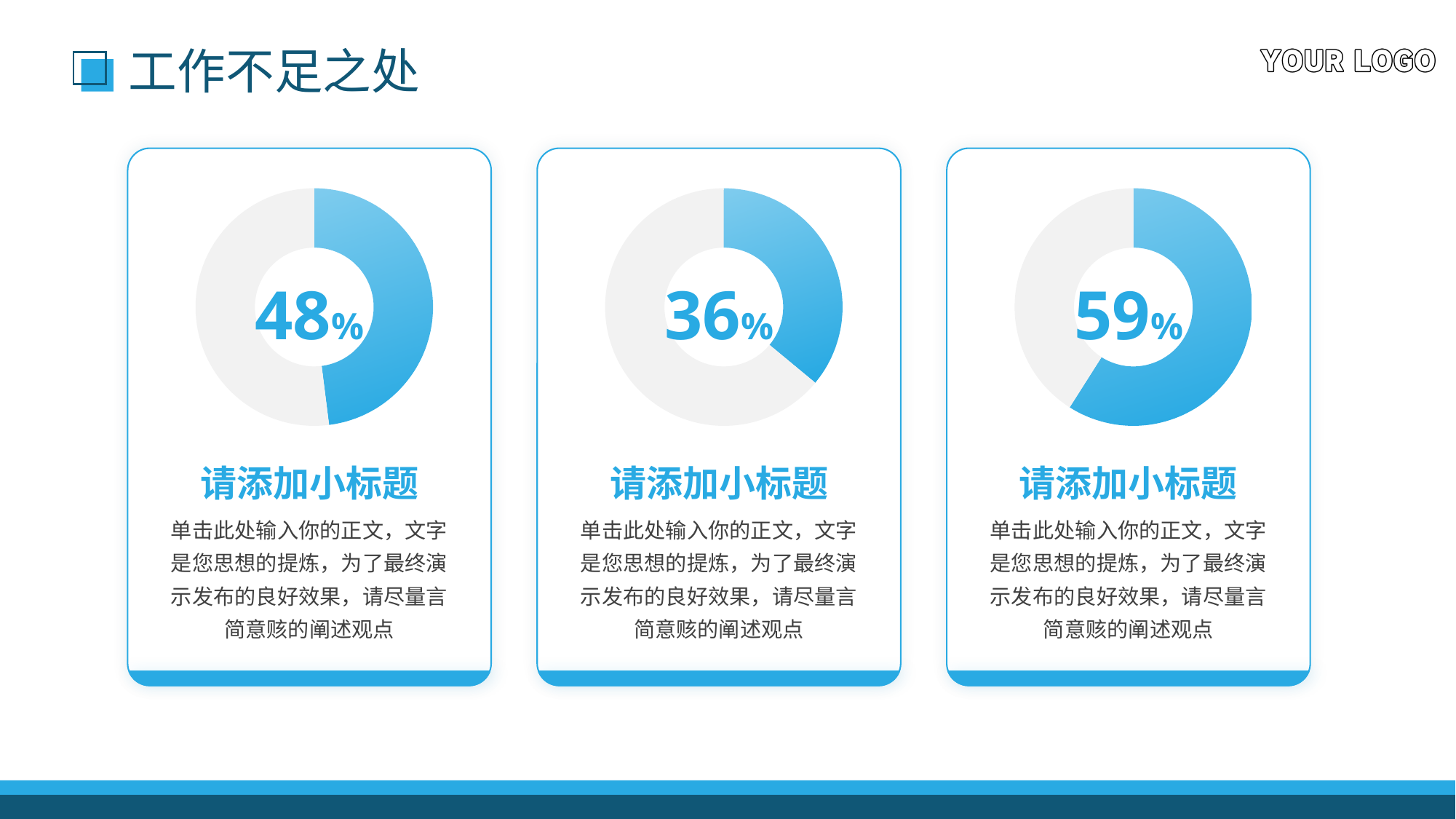
What value is shown in the left donut chart? 48% What kind of chart is used in each of the three cards on the slide? donut chart What is the difference between the percentage in the right donut chart and the percentage in the left donut chart? 11% Which of the three donut charts shows the lowest percentage: left, middle or right? middle Which of the three donut charts shows the highest percentage: left, middle or right? right What value is shown in the right donut chart? 59% What value is shown in the middle donut chart? 36% What is the difference between the percentage in the right donut chart and the percentage in the middle donut chart? 23% What colour is the filled portion of each donut chart? blue Which is larger, the percentage in the left donut chart or the percentage in the middle donut chart? left How many donut charts are on the slide? 3 What is the title of the slide? 工作不足之处